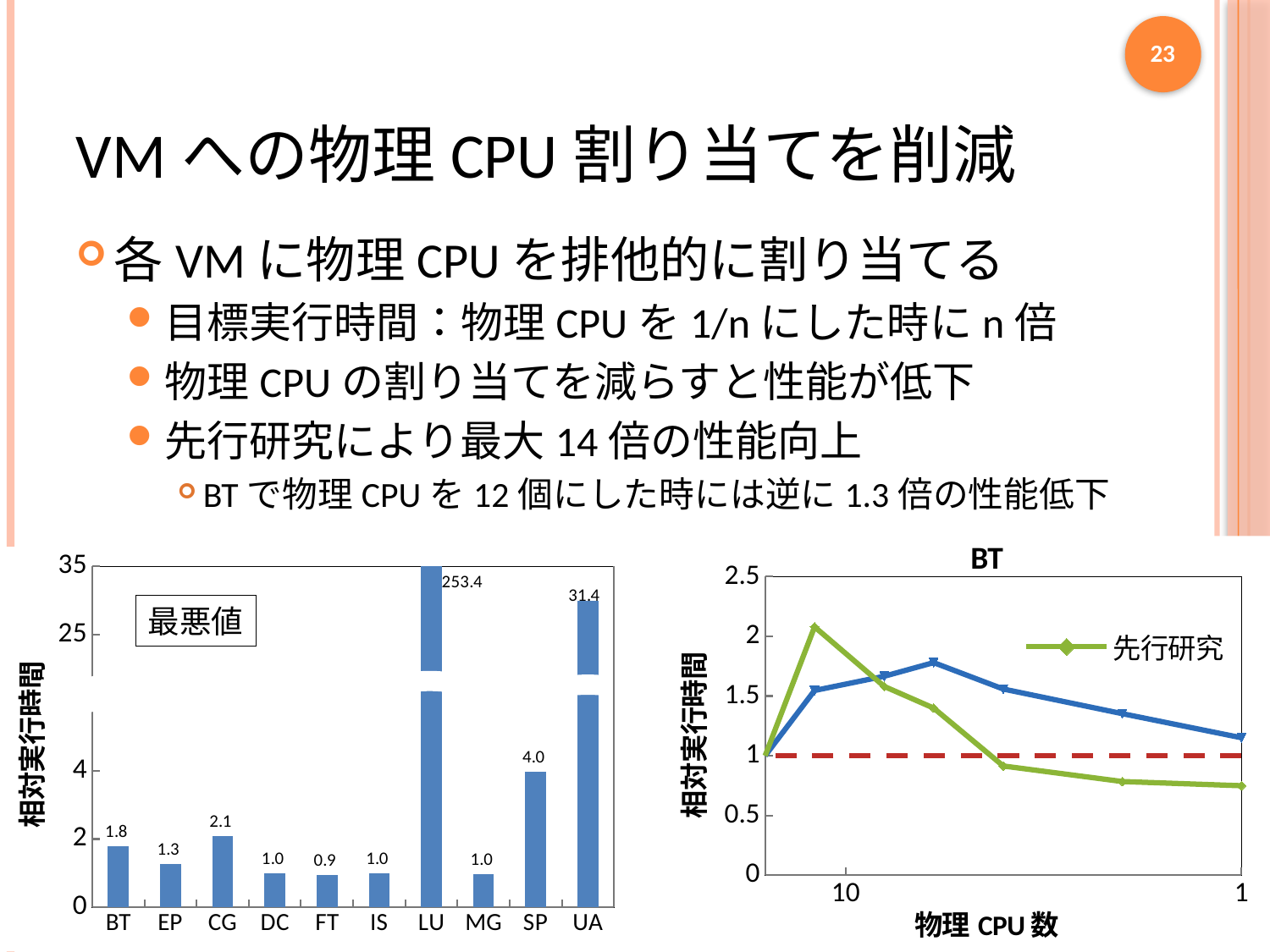
In the right chart (BT), is the highest value of the blue line greater or less than 2? less In the left bar chart (最悪値), which is larger, the value for CG or the value for BT? CG In the left bar chart (最悪値), what is the difference between the values for UA and SP? 27.4 What is the title of the chart on the right of the slide? BT In the left bar chart (最悪値), what is the value for SP? 4.0 In the left bar chart (最悪値), what is the value for LU? 253.4 In the left bar chart (最悪値), which category has the highest value? LU How many categories are shown on the x axis of the left bar chart (最悪値)? 10 What kind of chart is the chart on the left of the slide? bar chart In the right chart (BT), what entry does the legend show? 先行研究 In the left bar chart (最悪値), what is the value for EP? 1.3 In the left bar chart (最悪値), which category has the lowest value? FT